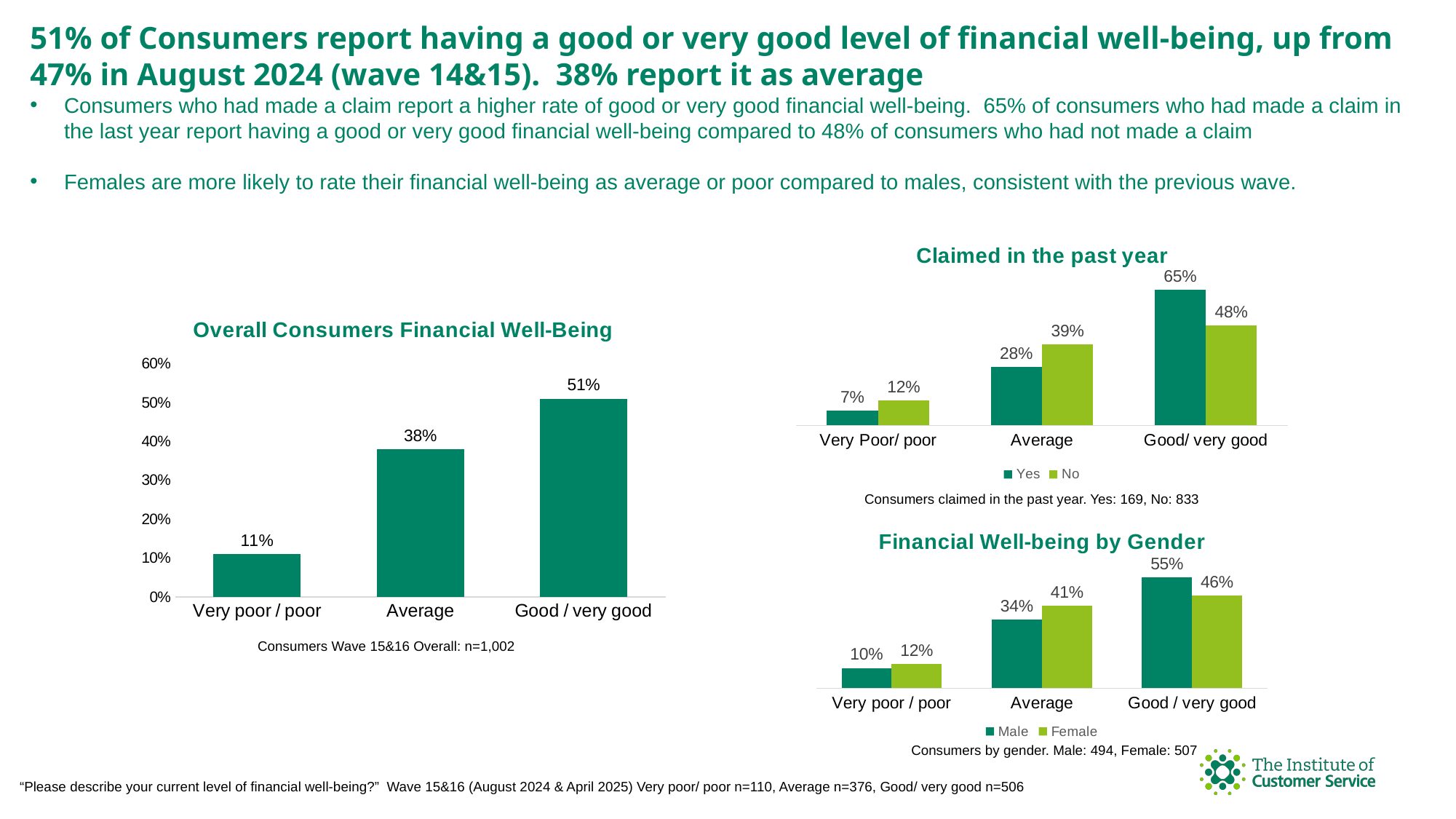
In the 'Overall Consumers Financial Well-Being' chart, how many categories are shown? 3 In the 'Overall Consumers Financial Well-Being' chart, what is the difference between Good / very good and Average? 13% In the 'Overall Consumers Financial Well-Being' chart, what is the value for Average? 38% In the 'Financial Well-being by Gender' chart, what is the difference between Male and Female in the Good / very good category? 9% In the 'Overall Consumers Financial Well-Being' chart, which category has the lowest value? Very poor / poor In the 'Overall Consumers Financial Well-Being' chart, which category has the highest value? Good / very good In the 'Financial Well-being by Gender' chart, which is larger for Good / very good, Male or Female? Male In the 'Claimed in the past year' chart, what is the value for No in the Average category? 39% What kind of chart is 'Overall Consumers Financial Well-Being'? Bar chart In the 'Claimed in the past year' chart, what is the value for Yes in the Good/ very good category? 65% In the 'Claimed in the past year' chart, how many series does the legend list? 2 In the 'Financial Well-being by Gender' chart, what is the value for Female in the Average category? 41%